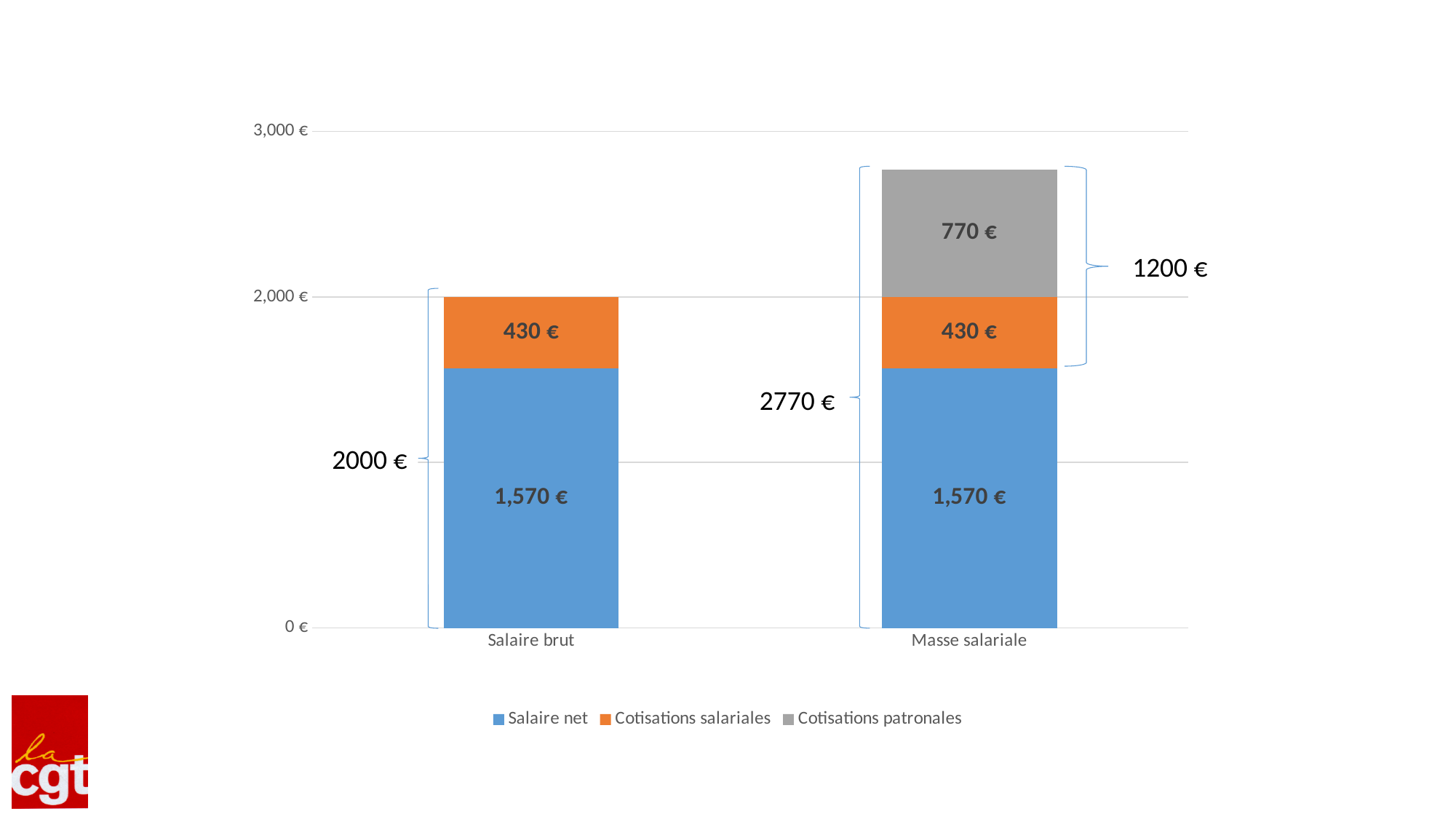
What is the total of the Salaire brut stacked bar? 2000 € Is the total of the Masse salariale bar greater or less than 3,000 €? less How many categories are shown on the x axis? 2 What is the value of Cotisations salariales for Masse salariale? 430 € Which category has the taller stacked bar, Salaire brut or Masse salariale? Masse salariale What is the value of Salaire net for Salaire brut? 1,570 € What kind of chart is shown on the slide? Stacked bar chart How many series does the legend list? 3 Which series is shown in grey in the legend? Cotisations patronales What is the difference between Cotisations patronales and Cotisations salariales for Masse salariale? 340 € What is the total of the Masse salariale stacked bar? 2770 € What is the value of Cotisations patronales for Masse salariale? 770 €